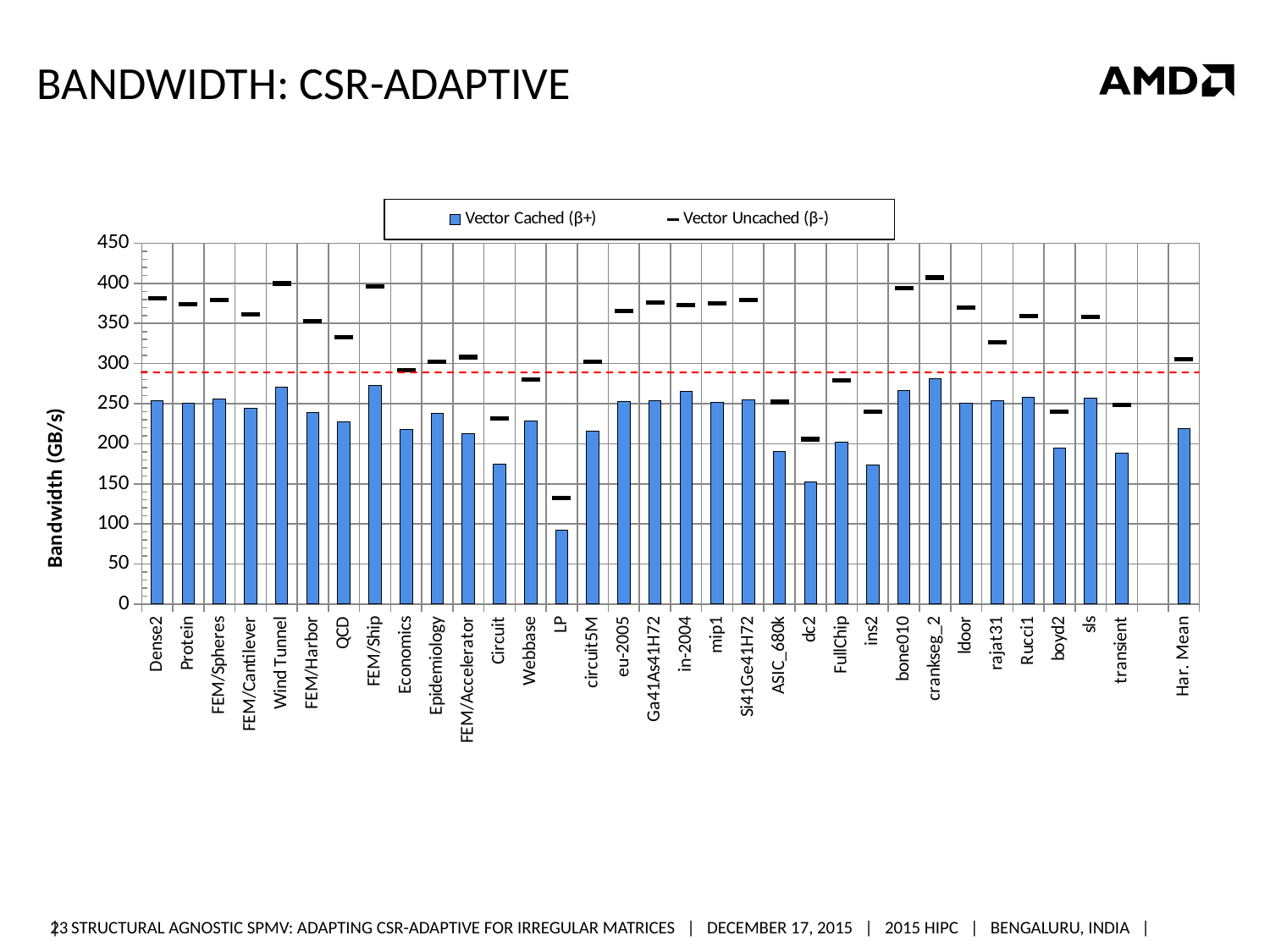
Is the Vector Cached (β+) value for dc2 greater or less than 200? less What kind of chart is shown on the slide? bar chart What is the label of the y axis? Bandwidth (GB/s) Which category has the lowest Vector Uncached (β-) marker? LP Which category has the highest Vector Cached (β+) bar? crankseg_2 How many series does the legend list? 2 Is the Vector Cached (β+) value for LP greater or less than 100? less What are the two series named in the legend? Vector Cached (β+) and Vector Uncached (β-) How many categories are shown along the x axis, including Har. Mean? 33 Which is larger, the Vector Uncached (β-) value for Wind Tunnel or for QCD? Wind Tunnel Which category has the lowest Vector Cached (β+) bar? LP Is the Vector Uncached (β-) value for Wind Tunnel greater or less than 350? greater